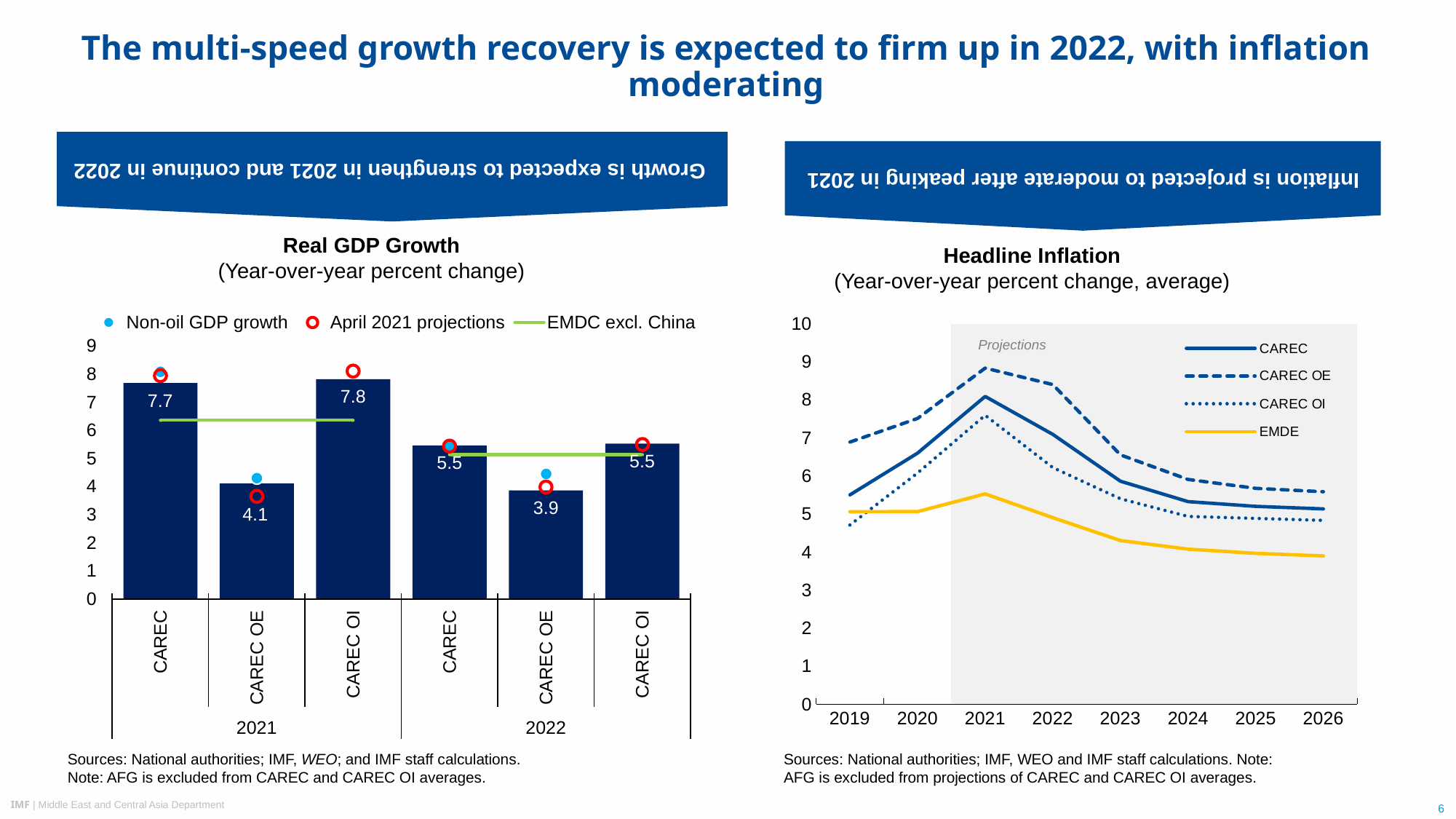
In the Real GDP Growth chart, what is the value for CAREC OE in 2022? 3.9 How many series does the legend of the Headline Inflation chart list? 4 In the Headline Inflation chart, does the EMDE line rise or fall from 2021 to 2026? Fall In the Real GDP Growth chart, which is larger: CAREC OE in 2021 or CAREC OE in 2022? CAREC OE in 2021 What kind of chart is the Headline Inflation chart? Line chart In the Real GDP Growth chart, what is the value for CAREC OI in 2021? 7.8 How many bars are plotted in the Real GDP Growth chart? 6 In the Headline Inflation chart, is the value for CAREC OE in 2021 greater or less than 8? greater In the Real GDP Growth chart, which bar is the lowest? CAREC OE in 2022 In the Real GDP Growth chart, what is the difference between the CAREC value in 2021 and the CAREC value in 2022? 2.2 In the Real GDP Growth chart, which bar is the highest? CAREC OI in 2021 How many entries does the legend of the Real GDP Growth chart list? 3